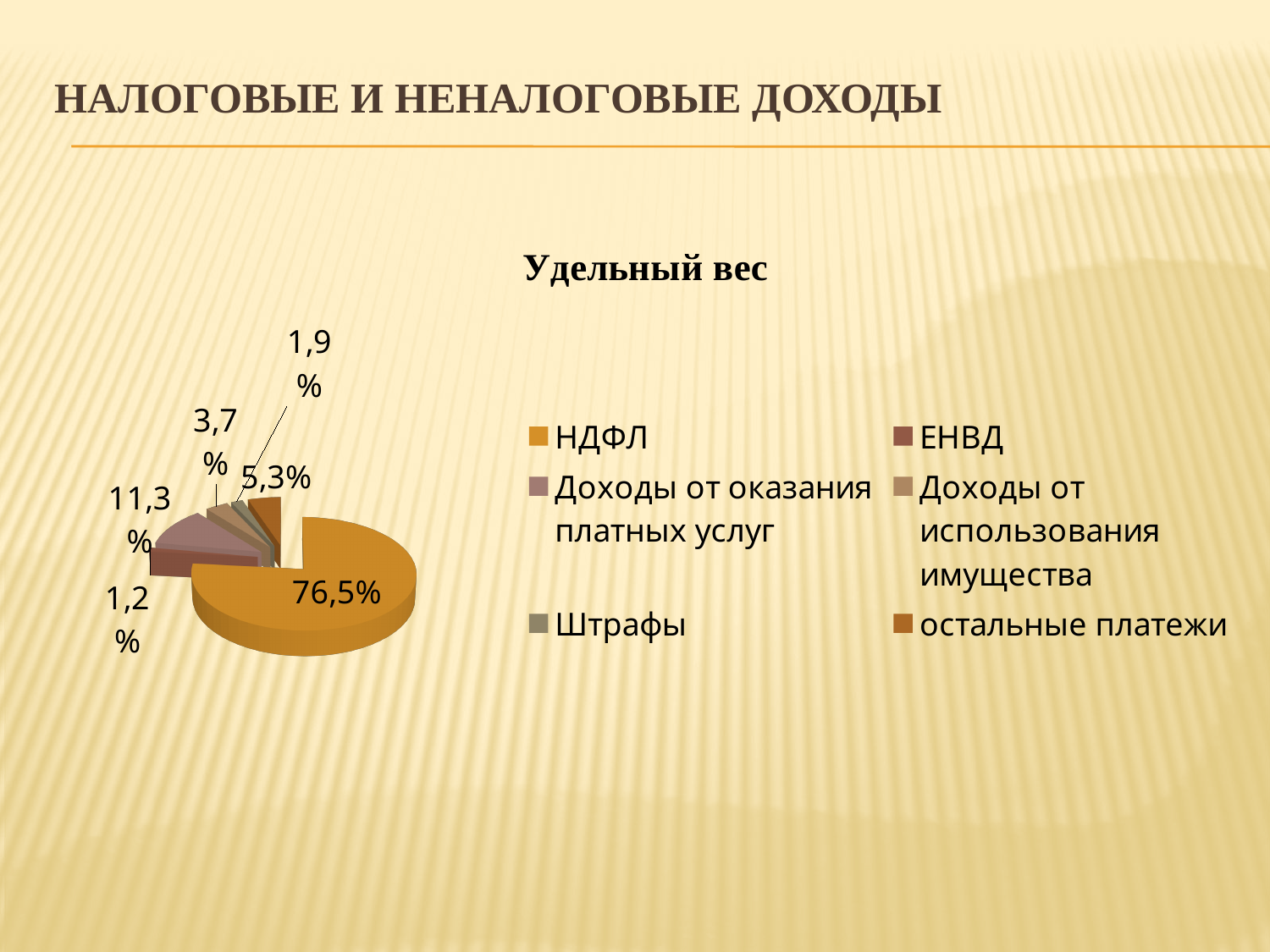
What is the difference between the share for НДФЛ and the share for Доходы от оказания платных услуг? 65,2% What is the title of the chart? Удельный вес How many categories does the legend of the chart list? 6 Which category has the largest share of the pie? НДФЛ What share of the pie does Доходы от оказания платных услуг have? 11,3% Which category is shown in the legend with the orange-yellow colour? НДФЛ What kind of chart is shown on the slide? pie chart Which category has the smallest share of the pie? ЕНВД What share of the pie does остальные платежи have? 5,3% What share of the pie does НДФЛ have? 76,5% What share of the pie does Доходы от использования имущества have? 3,7% Which is larger, the share for Доходы от оказания платных услуг or the share for остальные платежи? Доходы от оказания платных услуг